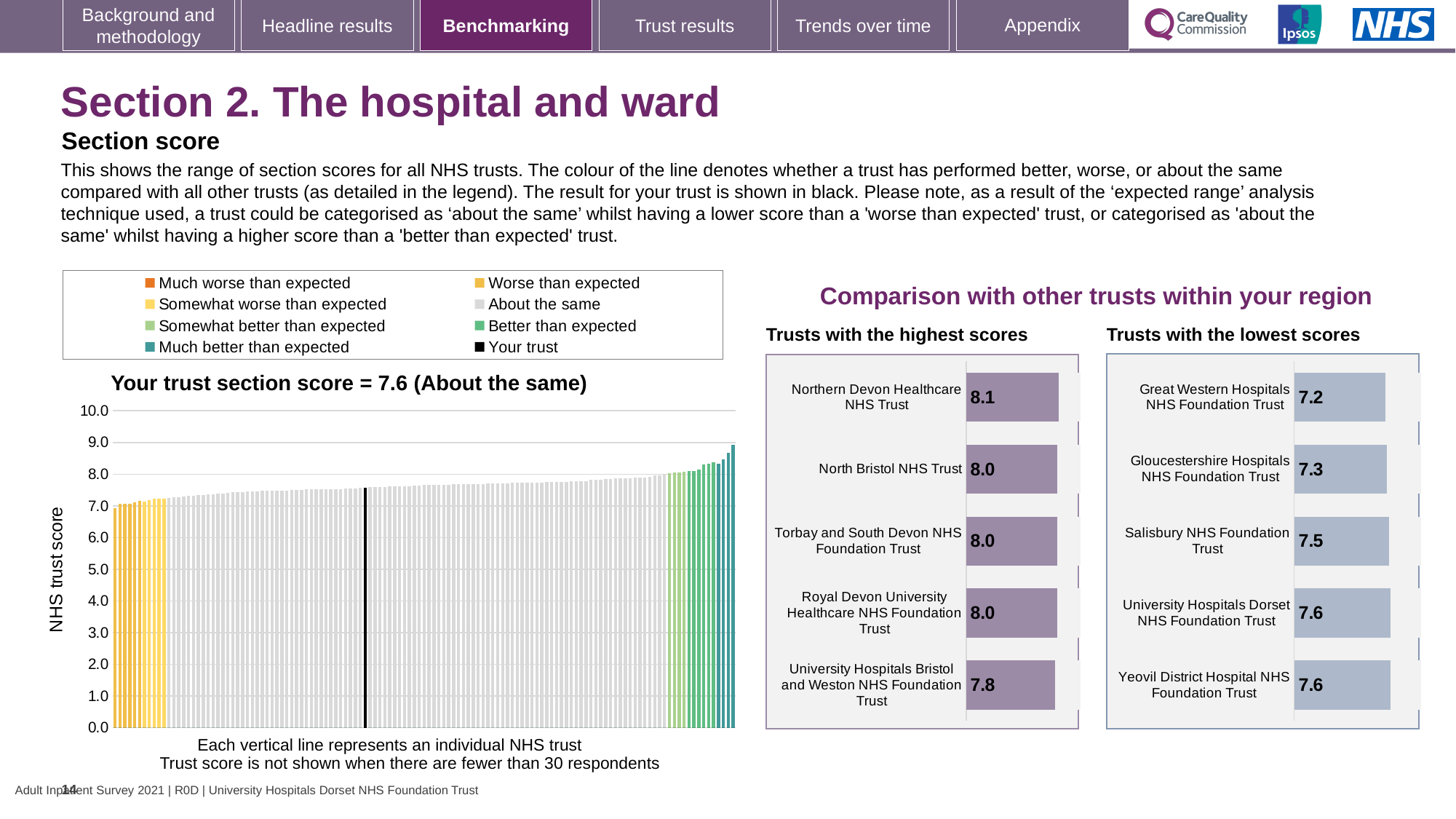
What kind of chart is the 'Your trust section score' chart? bar chart On the 'Trusts with the lowest scores' chart, which has the larger score: Gloucestershire Hospitals NHS Foundation Trust or Salisbury NHS Foundation Trust? Salisbury NHS Foundation Trust What is the label on the vertical axis of the 'Your trust section score' chart? NHS trust score On the 'Trusts with the lowest scores' chart, which trust has the lowest score? Great Western Hospitals NHS Foundation Trust On the 'Your trust section score' chart, do the trust scores rise or fall from left to right? rise On the 'Trusts with the highest scores' chart, what is the difference between the scores of Northern Devon Healthcare NHS Trust and University Hospitals Bristol and Weston NHS Foundation Trust? 0.3 On the 'Your trust section score' chart, what is the section score for your trust? 7.6 On the 'Trusts with the highest scores' chart, which trust has the lowest score? University Hospitals Bristol and Weston NHS Foundation Trust On the 'Your trust section score' chart, is the value for your trust (the black line) greater or less than 8.0? less On the 'Trusts with the lowest scores' chart, how many trusts are shown? 5 How many entries does the legend above the 'Your trust section score' chart list? 8 On the 'Trusts with the highest scores' chart, what is the score for Northern Devon Healthcare NHS Trust? 8.1